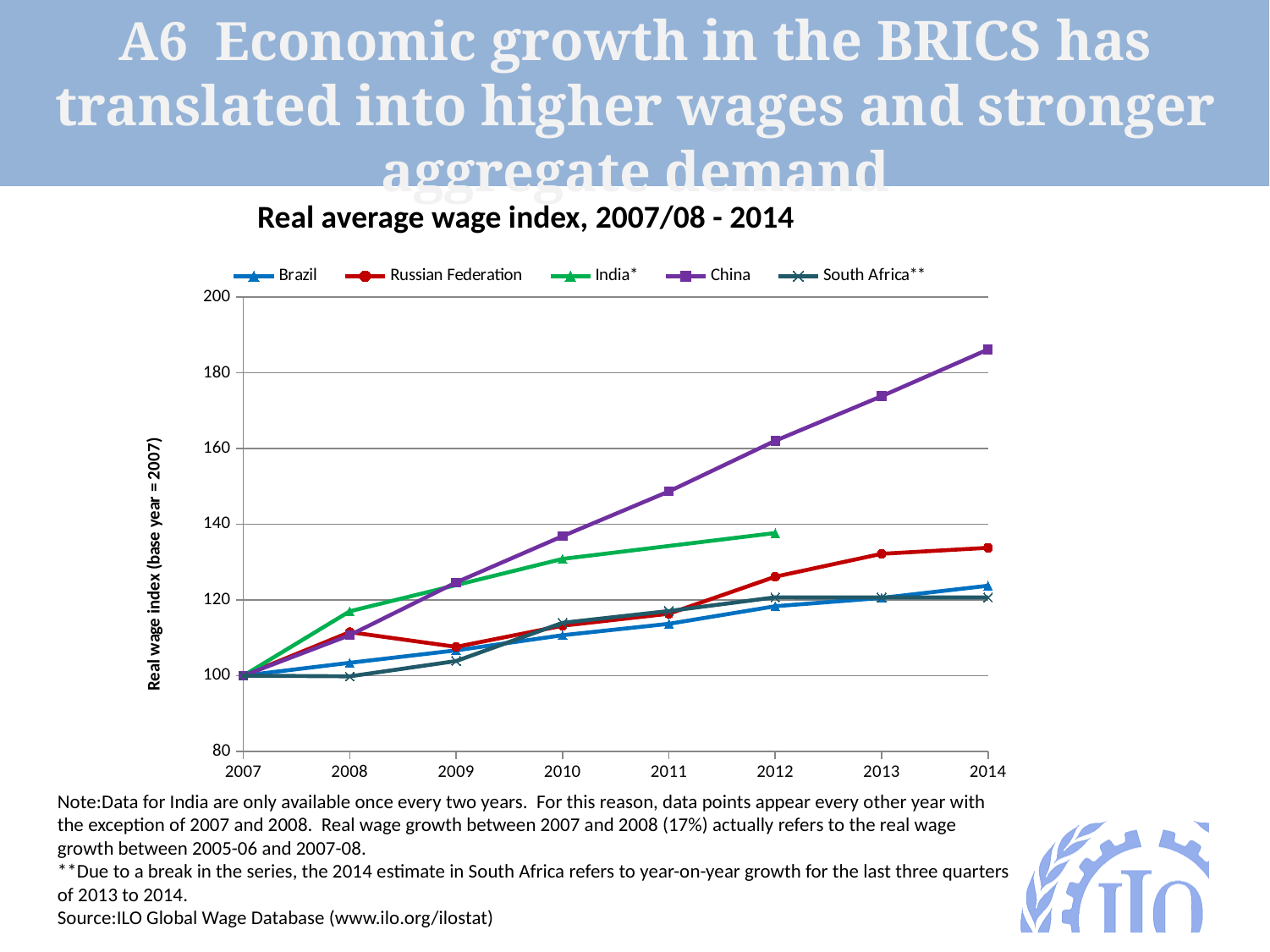
Which is larger in 2012, the value for China or the value for India*? China Which country has the highest real wage index in 2014? China Is the value for India* in 2012 greater or less than 140? less Is the value for China in 2014 greater or less than 180? greater Is the value for China in 2013 greater or less than 160? greater Does the value for China rise or fall from 2007 to 2014? rise How many years are shown along the x axis? 8 What is the title of the chart? Real average wage index, 2007/08 - 2014 What kind of chart is shown on the slide? line chart What is the value for China in 2007? 100 How many series does the legend list? 5